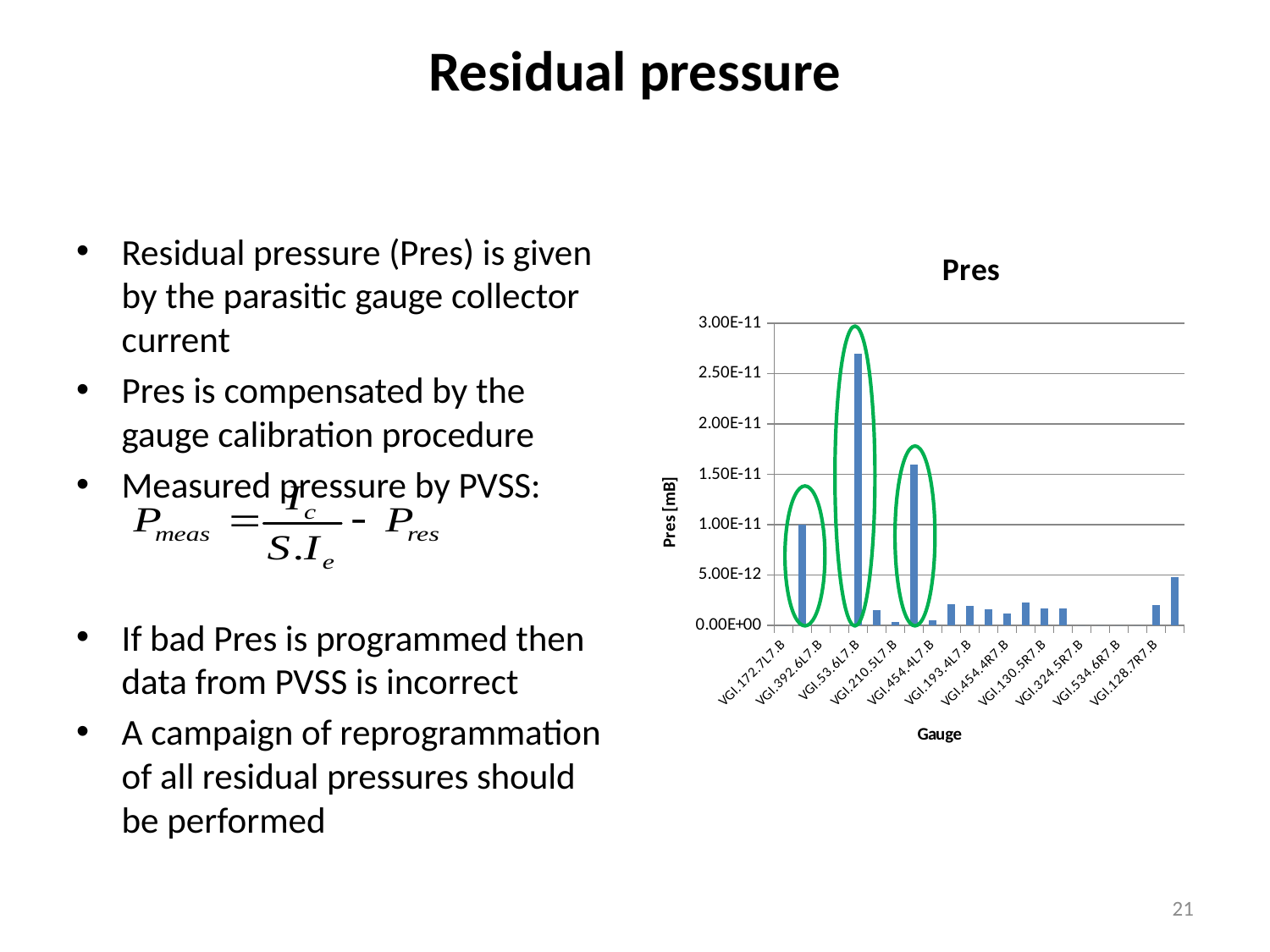
What is the label of the vertical axis of the chart? Pres [mB] What kind of chart is shown on the slide? bar chart Is the value for VGI.128.7R7.B greater or less than 5.00E-12? less Is the value for VGI.454.4L7.B greater or less than 1.00E-11? greater Is the value for VGI.193.4L7.B greater or less than 5.00E-12? less Which has the larger value, VGI.53.6L7.B or VGI.454.4L7.B? VGI.53.6L7.B Which gauge has the highest residual pressure in the chart? VGI.53.6L7.B Which has the larger value, VGI.172.7L7.B or VGI.128.7R7.B? VGI.172.7L7.B What is the title of the chart? Pres Which has the larger value, VGI.454.4L7.B or VGI.130.5R7.B? VGI.454.4L7.B